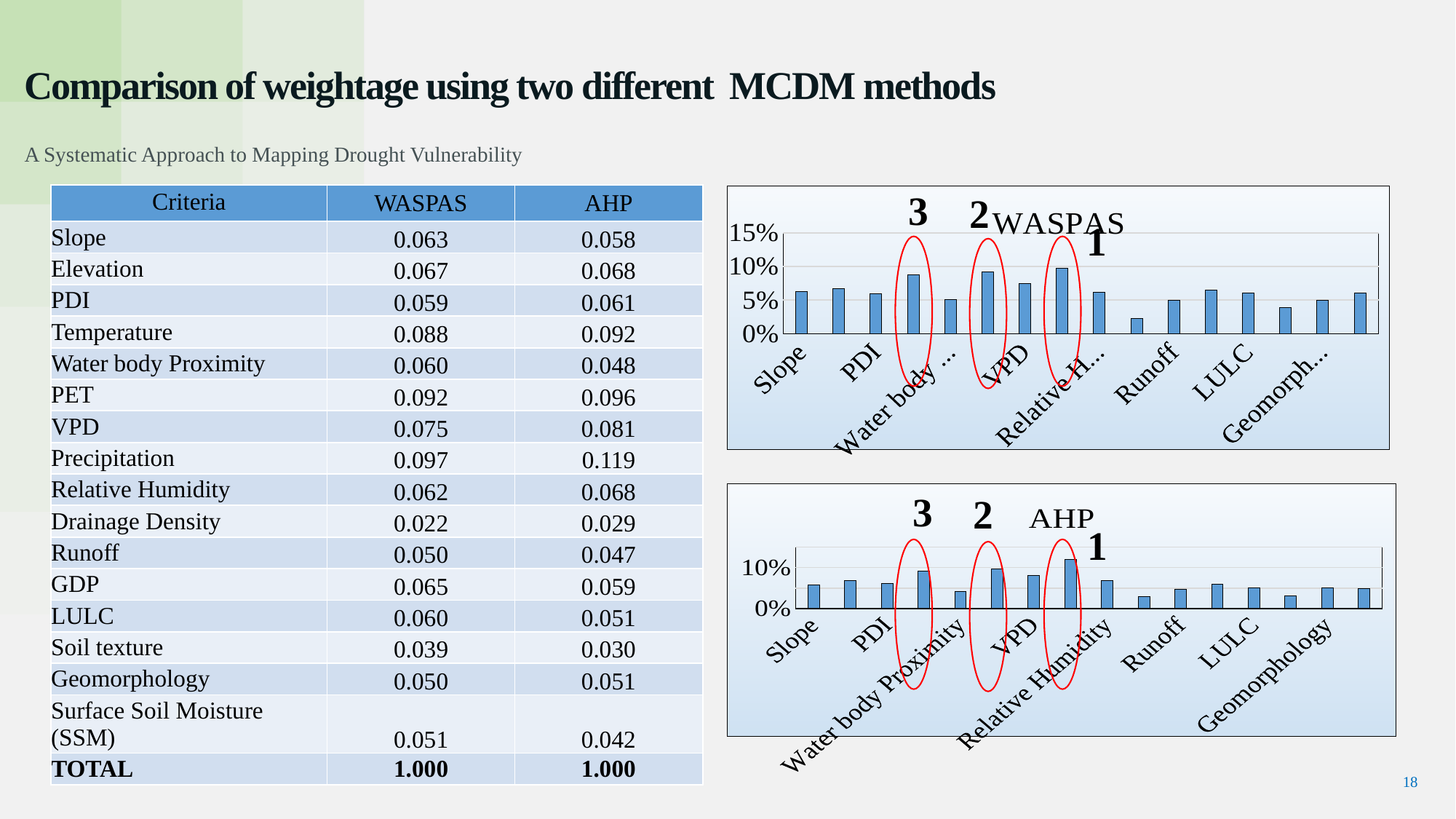
In the AHP chart, which is larger, the value for Relative Humidity or the value for LULC? Relative Humidity In the WASPAS chart, which is larger, the value for VPD or the value for Slope? VPD How many bars are plotted in the AHP chart? 16 In the AHP chart, which is larger, the value for Slope or the value for Water body Proximity? Slope In the WASPAS chart, is the value for Slope greater or less than 5%? greater In the WASPAS chart, is the value for VPD greater or less than 10%? less What kind of chart is the WASPAS chart on the right of the slide? bar chart In the AHP chart, is the value for Relative Humidity greater or less than 10%? less What is the highest tick label shown on the vertical axis of the WASPAS chart? 15%